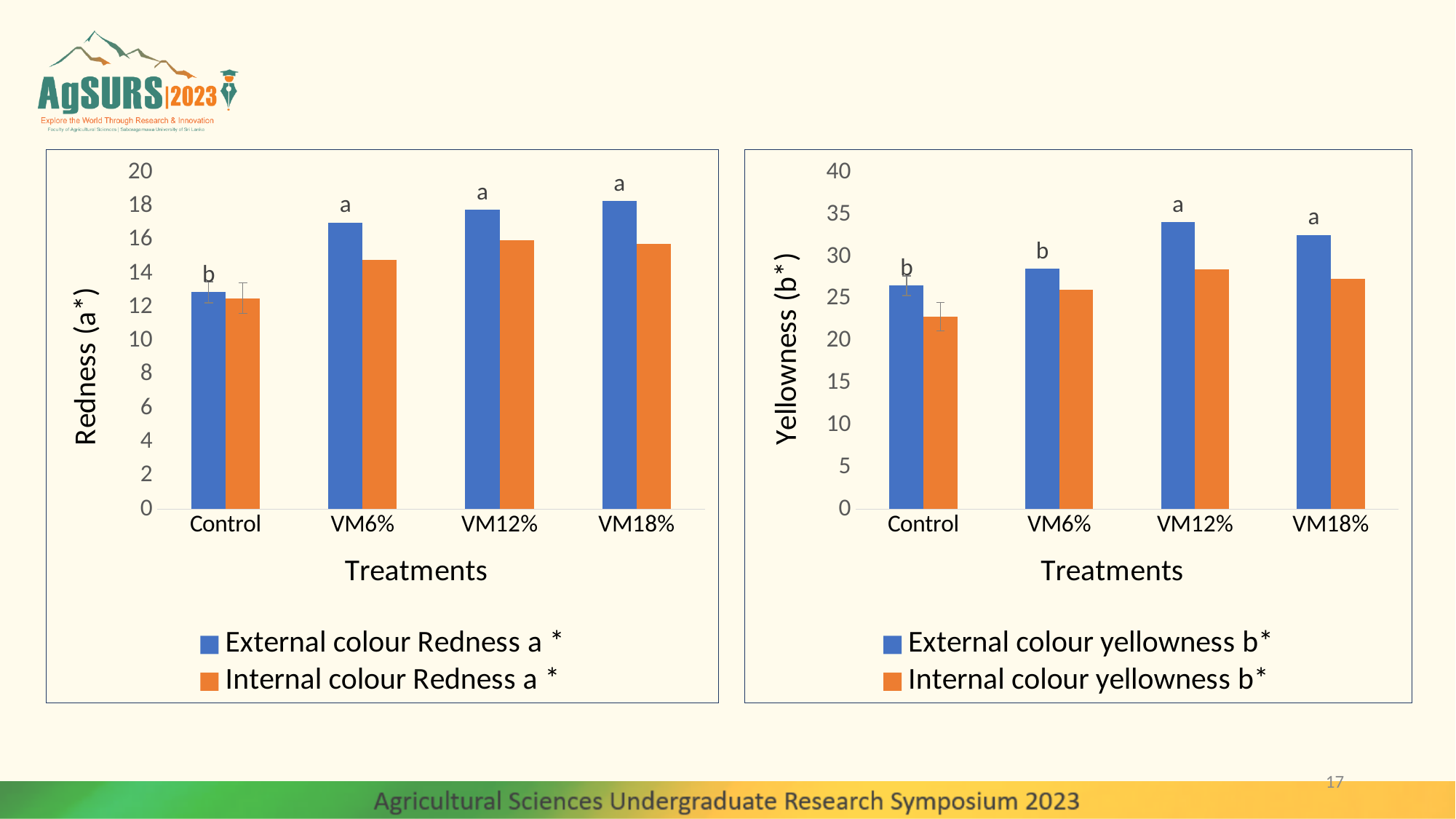
In the left chart (Redness), which treatment has the lowest Internal colour Redness bar? Control In the left chart (Redness), does the External colour Redness series rise or fall from Control to VM18%? rise What kind of chart is the left chart (Redness)? bar chart In the right chart (Yellowness), is the Internal colour yellowness value for Control greater or less than 25? less In the left chart (Redness), is the External colour Redness value for VM6% greater or less than 14? greater In the right chart (Yellowness), which treatment has the highest External colour yellowness bar? VM12% What is the x-axis title of the right chart (Yellowness)? Treatments In the right chart (Yellowness), which is larger for VM12%: External colour yellowness or Internal colour yellowness? External colour yellowness How many series does the legend of the left chart (Redness) list? 2 How many treatment categories are shown on the x axis of the right chart (Yellowness)? 4 In the right chart (Yellowness), which treatment has the lowest Internal colour yellowness bar? Control In the left chart (Redness), which treatment has the highest External colour Redness bar? VM18%